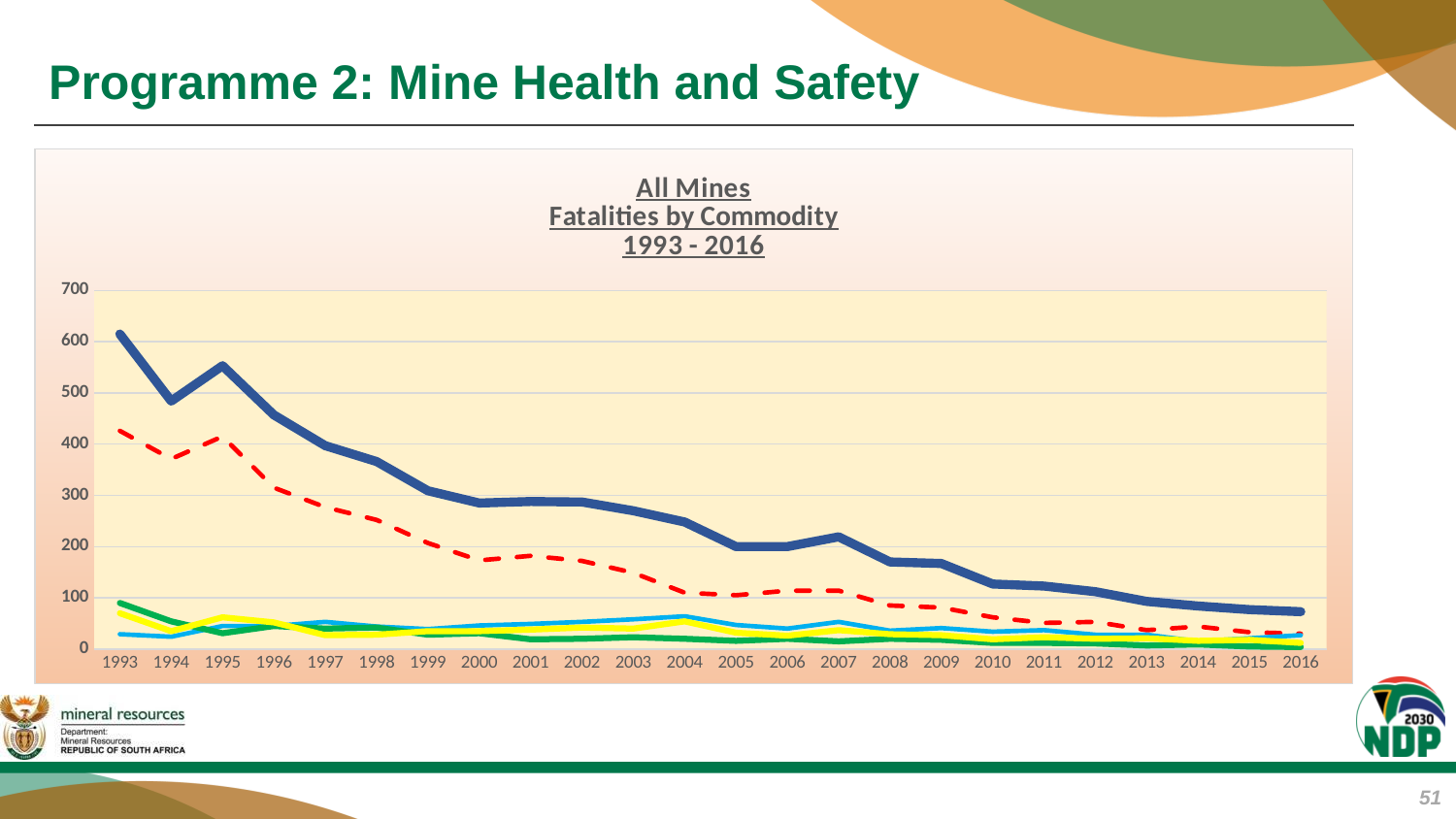
In 1993, which line has the higher value, the thick blue line or the red dashed line? the thick blue line How many years are shown along the x axis of the chart? 24 Is the value of the thick blue line in 1993 greater or less than 500? greater Is the value of the thick blue line in 2016 greater or less than 100? less What is the title of the chart? All Mines Fatalities by Commodity 1993 - 2016 Is the value of the red dashed line in 1993 greater or less than 300? greater What is the highest value shown on the y axis of the chart? 700 In which year is the thick blue line at its highest value? 1993 Does the thick blue line rise or fall from 1993 to 2016? fall How many lines are plotted on the chart? 5 What type of chart is shown on the slide? line chart